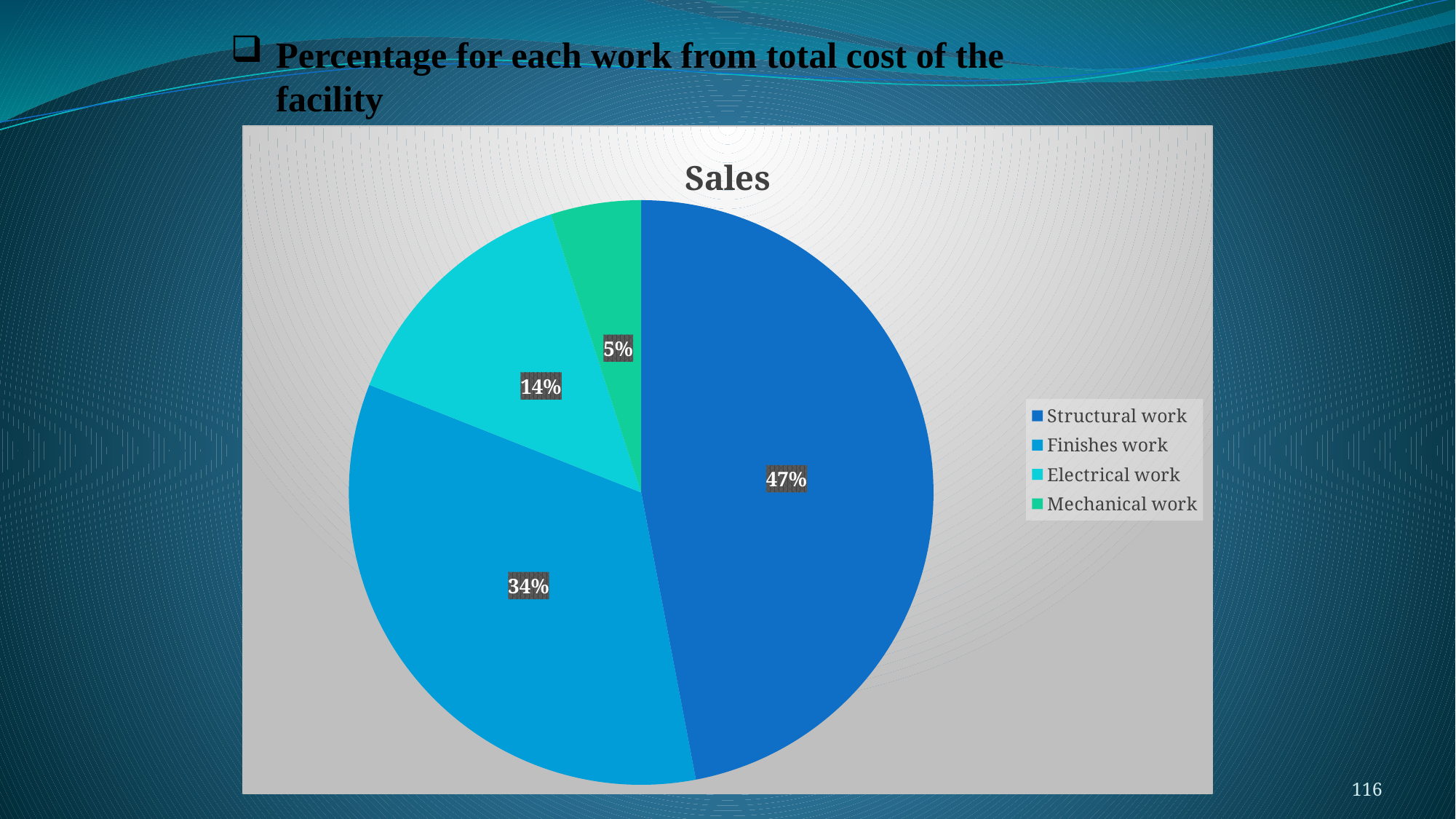
What is the difference in percentage points between Structural work and Finishes work? 13 Which category has the smallest share of the pie? Mechanical work What percentage does Finishes work account for? 34% What percentage does Electrical work account for? 14% What percentage does Mechanical work account for? 5% What is the title of the chart? Sales What percentage does Structural work account for? 47% Which is larger, Electrical work or Mechanical work? Electrical work What is the combined share of Electrical work and Mechanical work? 19% How many categories does the legend list? 4 Which category has the largest share of the pie? Structural work What type of chart is shown on the slide? pie chart